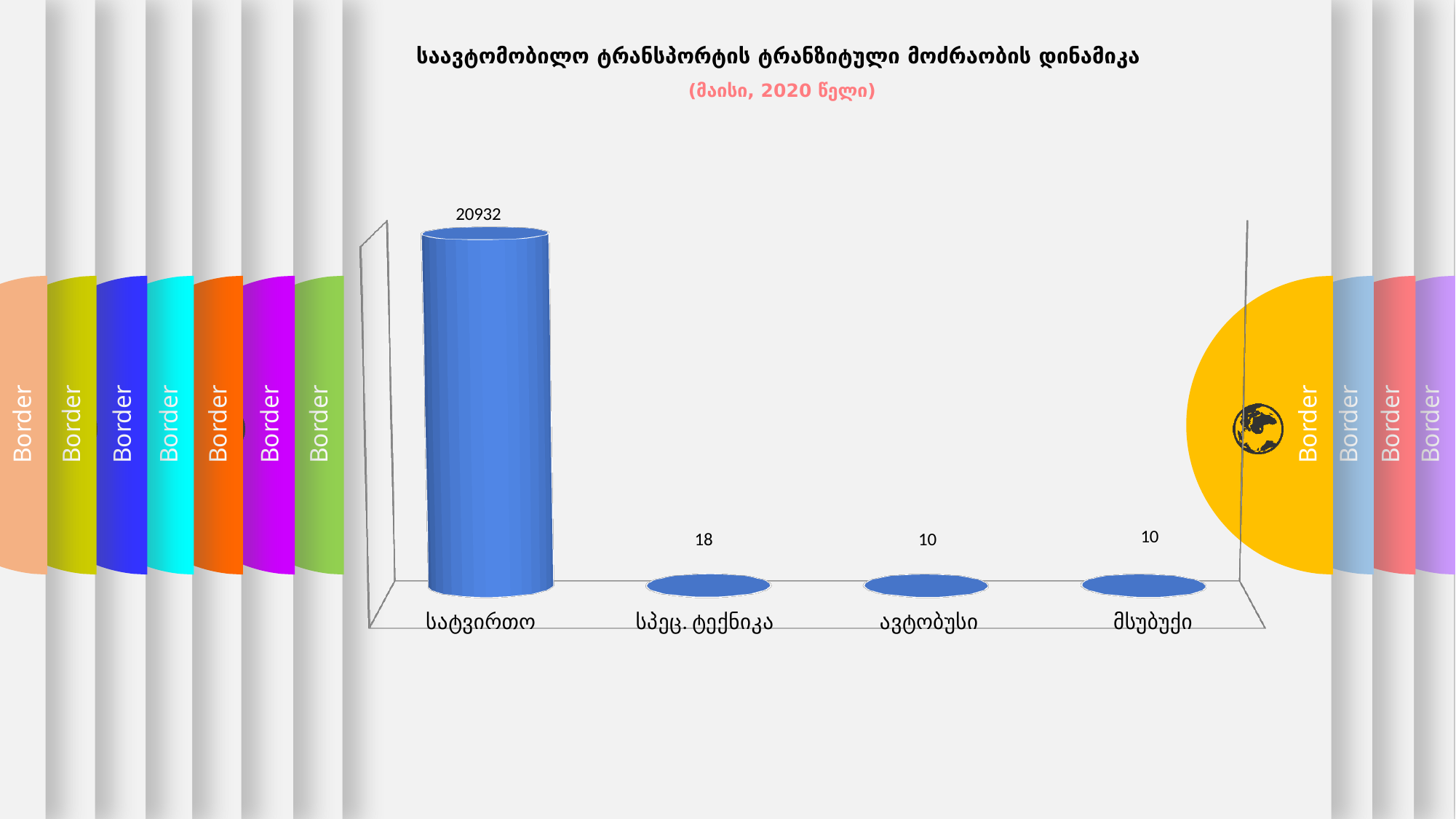
What kind of chart is shown on the slide? bar chart What is the value for მსუბუქი? 10 Which is larger, the value for სპეც. ტექნიკა or the value for მსუბუქი? სპეც. ტექნიკა What is the value for სპეც. ტექნიკა? 18 What is the difference between the values for სპეც. ტექნიკა and ავტობუსი? 8 What colour are the bars in the chart? blue Which category has the highest value? სატვირთო What is the value for სატვირთო? 20932 How many categories are shown on the chart? 4 What period is given in the chart's subtitle? მაისი, 2020 წელი What is the value for ავტობუსი? 10 What is the difference between the values for სატვირთო and სპეც. ტექნიკა? 20914